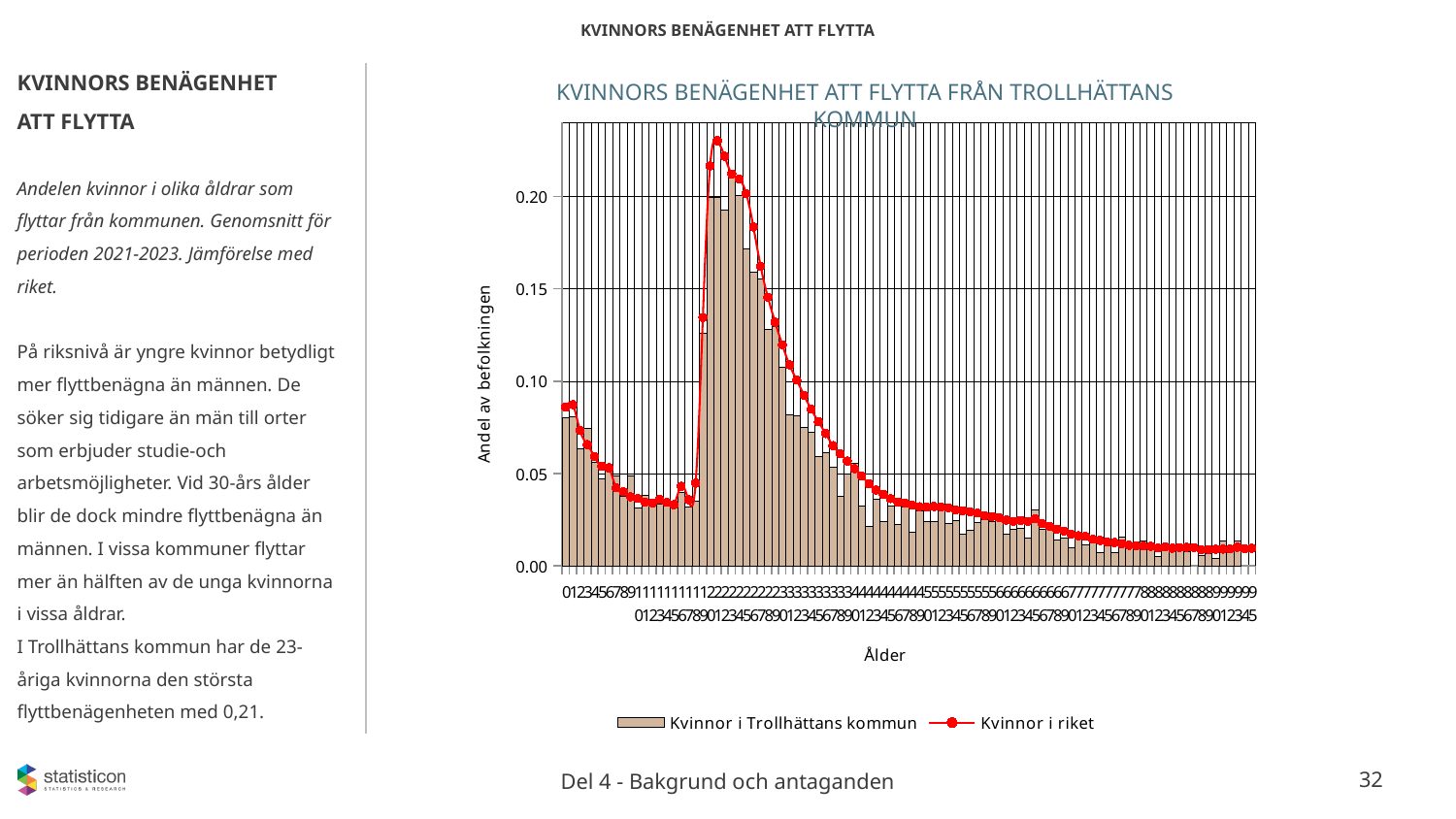
What is the label of the y axis of the chart? Andel av befolkningen Is the value of the Kvinnor i riket line at age 0 greater or less than 0.05? greater What is the title of the chart? KVINNORS BENÄGENHET ATT FLYTTA FRÅN TROLLHÄTTANS KOMMUN Which series is drawn as a red line with markers? Kvinnor i riket How many series does the chart legend list? 2 Is the value of the Kvinnor i Trollhättans kommun bar at age 0 greater or less than 0.10? less Which series reaches the higher maximum value in the chart? Kvinnor i riket What kind of chart is shown on the slide? A combined bar and line chart At the peak of the chart (early twenties), which series reaches the higher value, Kvinnor i Trollhättans kommun or Kvinnor i riket? Kvinnor i riket After the peak in the early twenties, do the values of the Kvinnor i riket line rise or fall as age increases? fall Is the highest value of the red line (Kvinnor i riket) greater or less than 0.20? greater